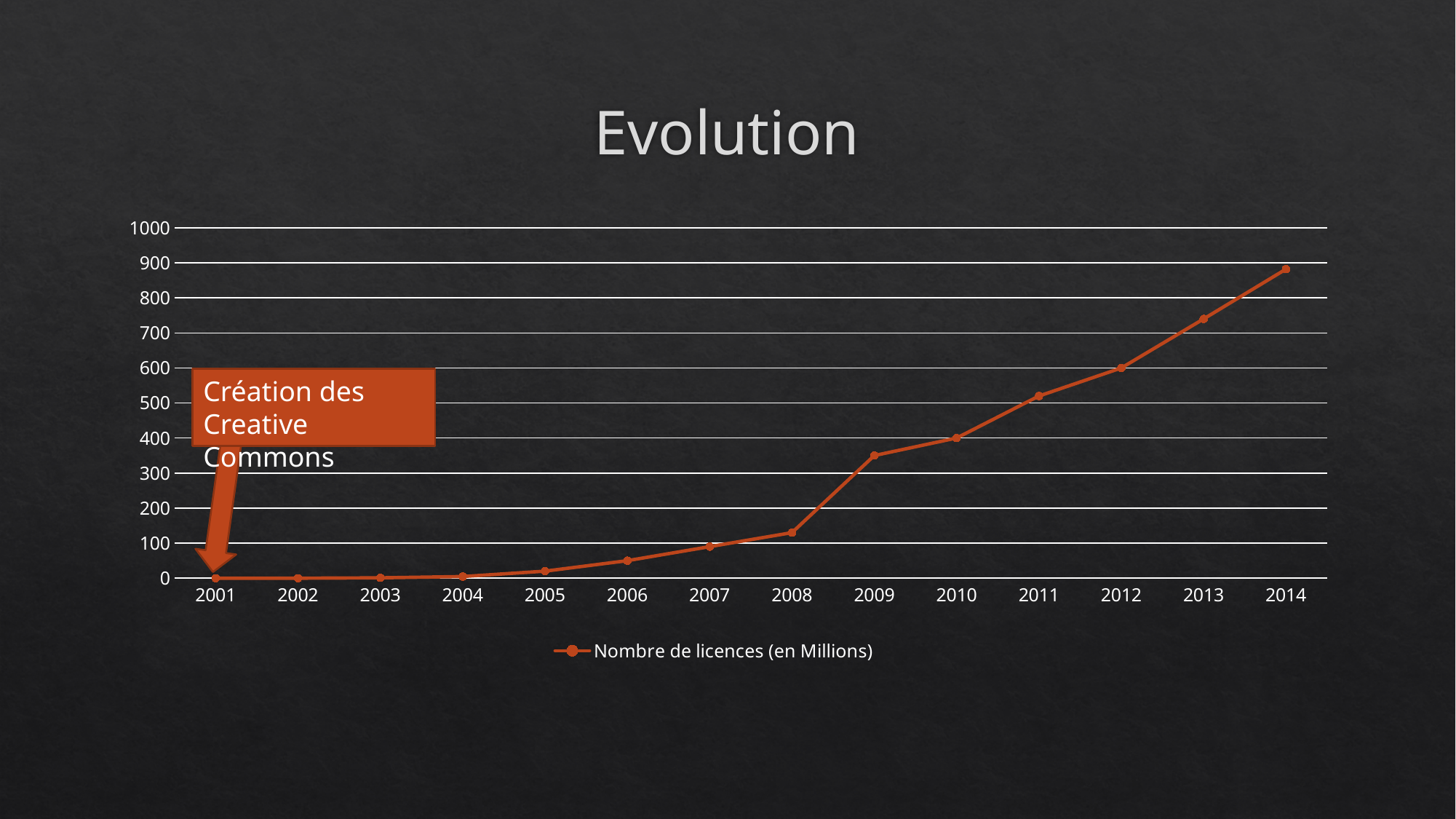
Is the value for 2013 greater or less than 700? greater What is the name of the series shown in the legend? Nombre de licences (en Millions) Is the value for 2009 greater or less than 300? greater How many years are plotted along the x axis? 14 How many series does the legend list? 1 Is the value for 2014 greater or less than 900? less Which year has the larger value, 2008 or 2009? 2009 What is the title of the slide? Evolution What kind of chart is shown on the slide? line chart Which year has the highest number of licences? 2014 Do the values rise or fall from 2001 to 2014? rise